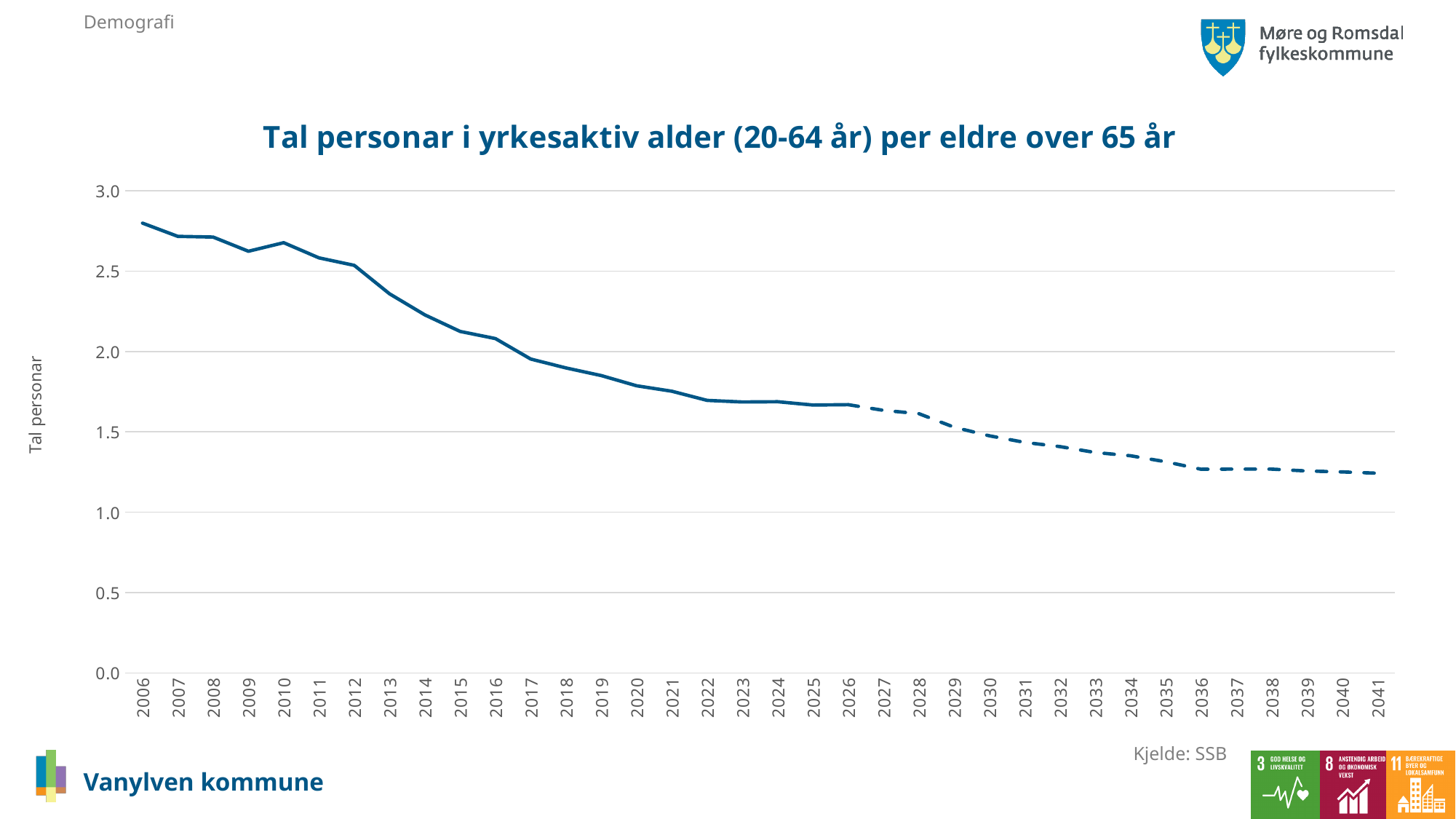
What is the label on the vertical axis of the chart? Tal personar Is the value for 2022 greater or less than 1.5? greater Which year has the highest value on the chart? 2006 What kind of chart is shown on the slide? line chart What is the title of the chart? Tal personar i yrkesaktiv alder (20-64 år) per eldre over 65 år Is the value for 2013 greater or less than 2.5? less Is the value for 2006 greater or less than 2.5? greater Which year has the larger value, 2010 or 2012? 2010 Which year has the lowest value on the chart? 2041 How many years are plotted along the x axis of the chart? 36 Do the values rise or fall from 2006 to 2041? fall